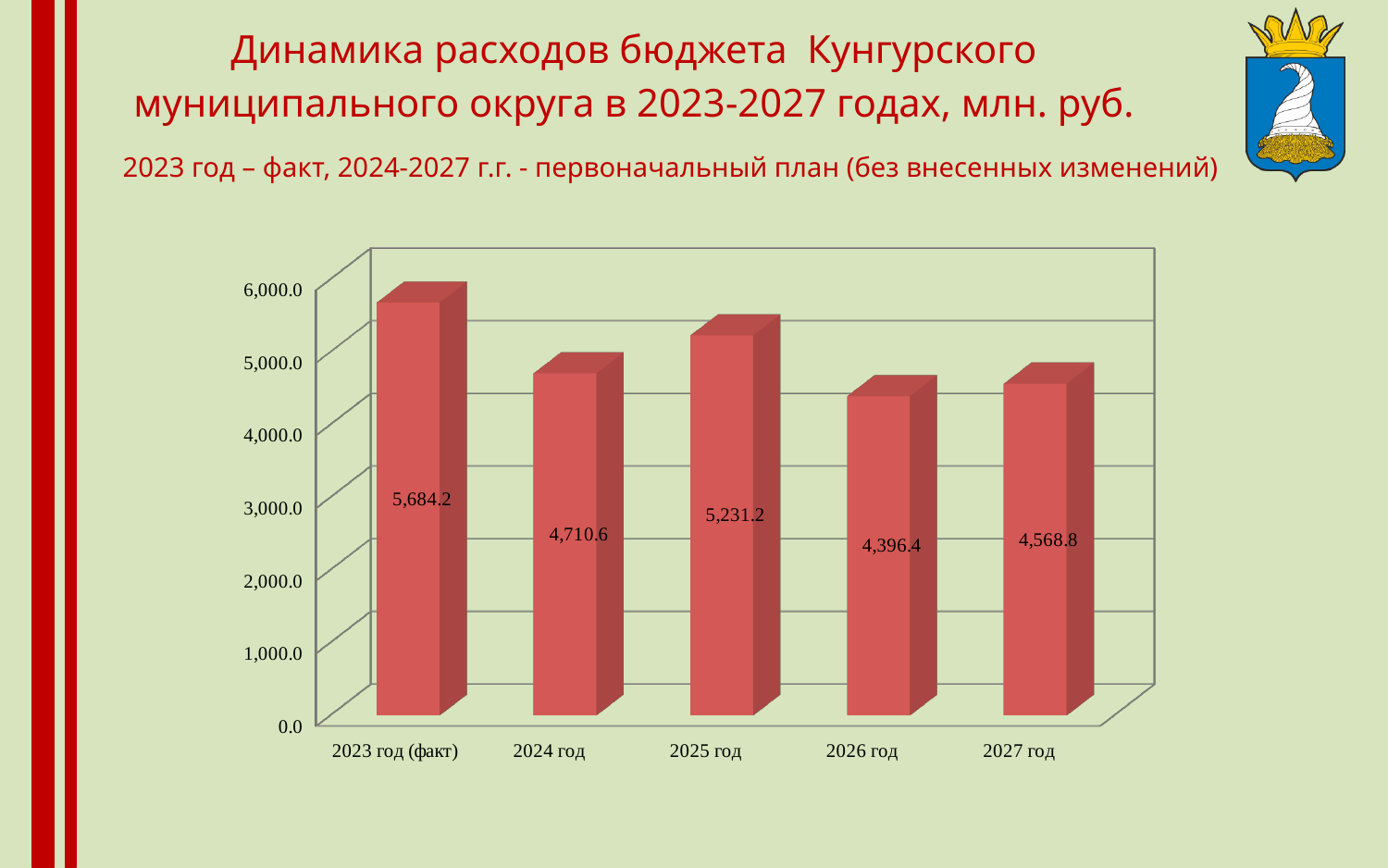
What is the value for 2027 год? 4,568.8 What is the value for 2025 год? 5,231.2 How many years are shown on the x axis? 5 Which year has the highest value? 2023 год (факт) Which is larger, the value for 2025 год or the value for 2024 год? 2025 год What is the difference between the values for 2023 год (факт) and 2024 год? 973.6 What is the difference between the values for 2027 год and 2026 год? 172.4 What kind of chart is shown on the slide? bar chart What is the value for 2023 год (факт)? 5,684.2 Is the value for 2026 год greater or less than 5,000.0? less Do the values rise or fall from 2023 год (факт) to 2024 год? fall Which year has the lowest value? 2026 год